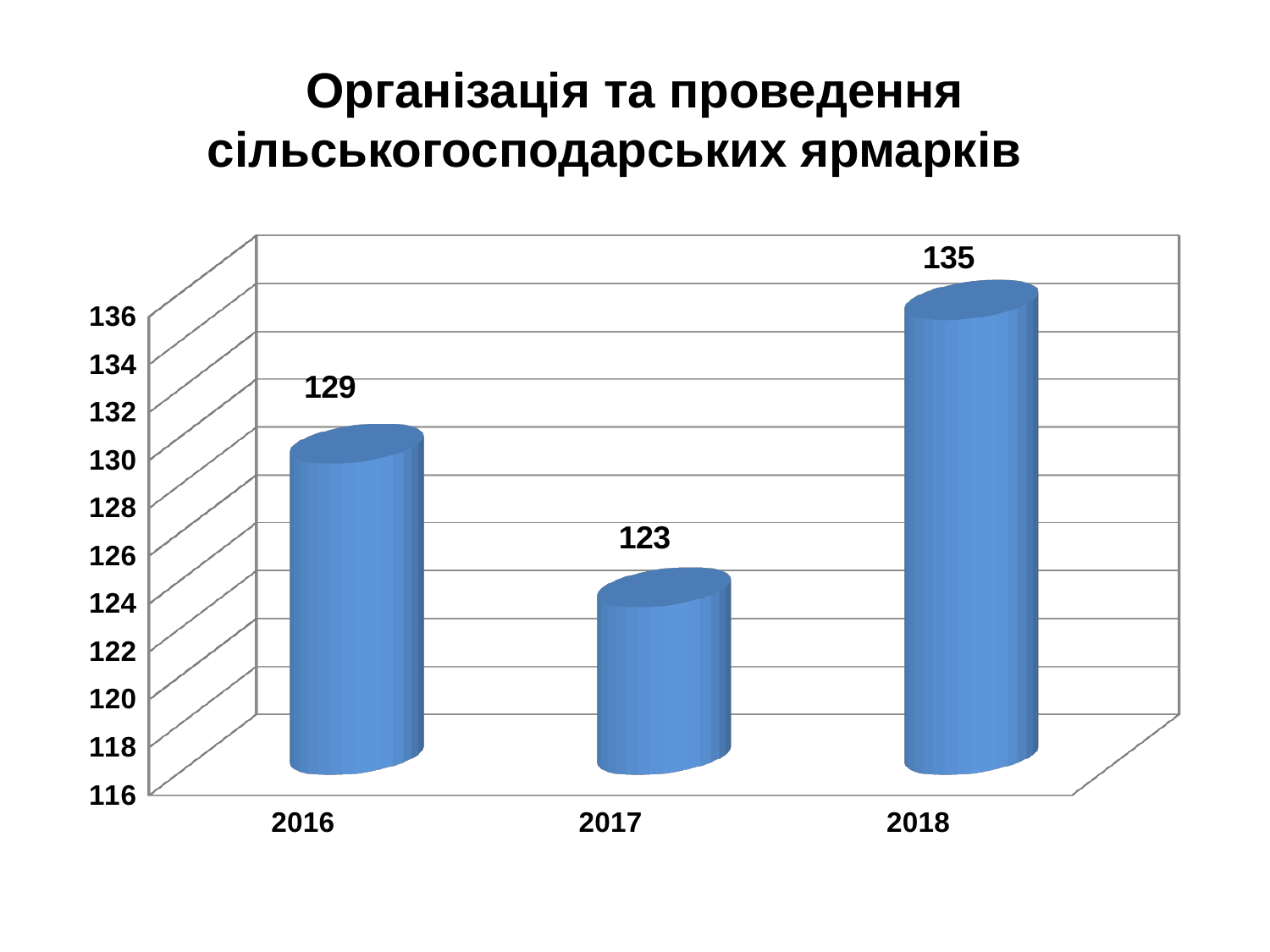
What is the value for 2016? 129 Which is larger, the value for 2016 or the value for 2018? 2018 What is the value for 2017? 123 Is the value for 2017 greater or less than 126? less What is the difference between the values for 2016 and 2017? 6 How many years are shown on the chart? 3 What is the title of the chart? Організація та проведення сільськогосподарських ярмарків Which year has the lowest value? 2017 Which year has the highest value? 2018 What is the value for 2018? 135 What is the difference between the values for 2018 and 2017? 12 What kind of chart is shown on the slide? bar chart